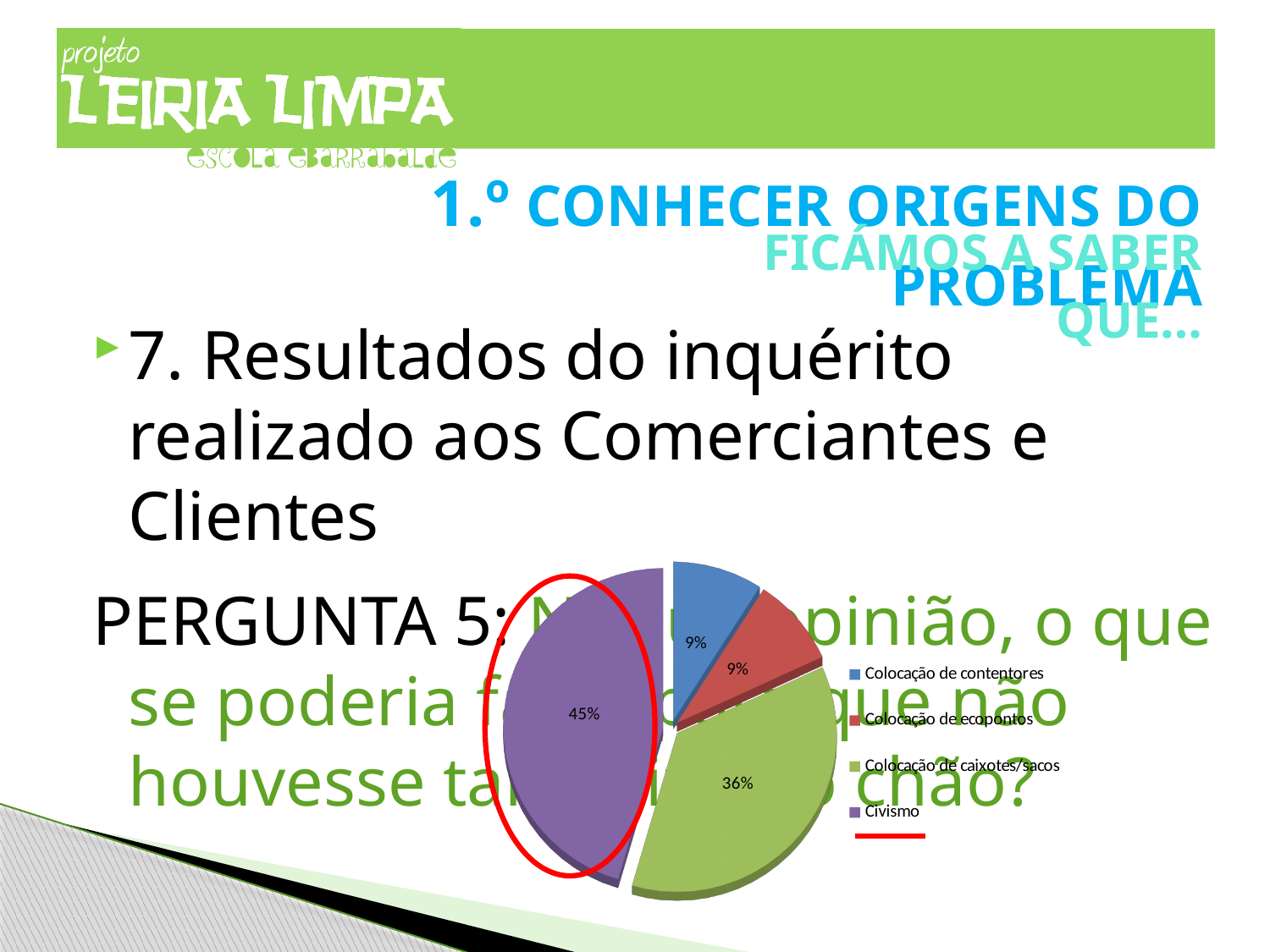
What colour is the Civismo slice in the pie chart? purple What kind of chart is shown on the slide? pie chart What percentage of the pie chart corresponds to Colocação de contentores? 9% What percentage of the pie chart corresponds to Civismo? 45% What is the difference in percentage points between the Civismo slice and the Colocação de caixotes/sacos slice? 9 What percentage of the pie chart corresponds to Colocação de caixotes/sacos? 36% How many slices does the pie chart have? 4 How many entries does the legend of the pie chart list? 4 Which category has the largest slice in the pie chart? Civismo What percentage of the pie chart corresponds to Colocação de ecopontos? 9% Which legend entry in the pie chart is underlined in red? Civismo Which slice is larger in the pie chart: Civismo or Colocação de caixotes/sacos? Civismo